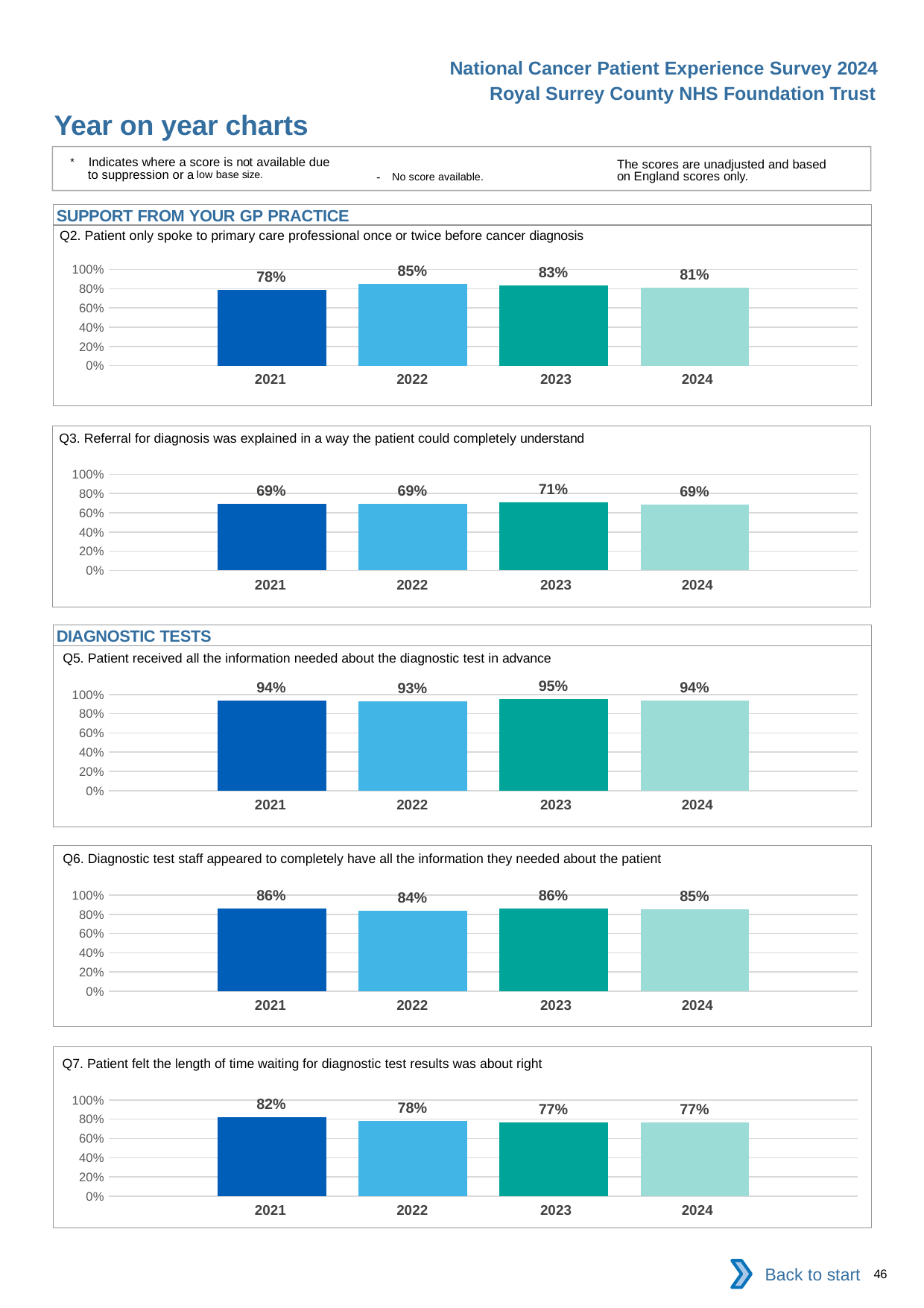
In the Q2 chart, what is the value for 2022? 85% In the Q6 chart, what is the value for 2022? 84% In the Q5 chart, how many years are plotted? 4 In the Q2 chart, which year has the lowest value? 2021 In the Q7 chart, do the values rise or fall from 2021 to 2023? fall In the Q7 chart, what is the value for 2021? 82% In the Q3 chart, which year has the highest value? 2023 In the Q6 chart, which is larger, the value for 2021 or the value for 2024? 2021 In the Q5 chart, what is the difference between the 2023 value and the 2022 value? 2% In the Q7 chart, what is the difference between the 2021 value and the 2024 value? 5% What kind of chart is the Q2 chart? bar chart In the Q3 chart, what is the value for 2024? 69%